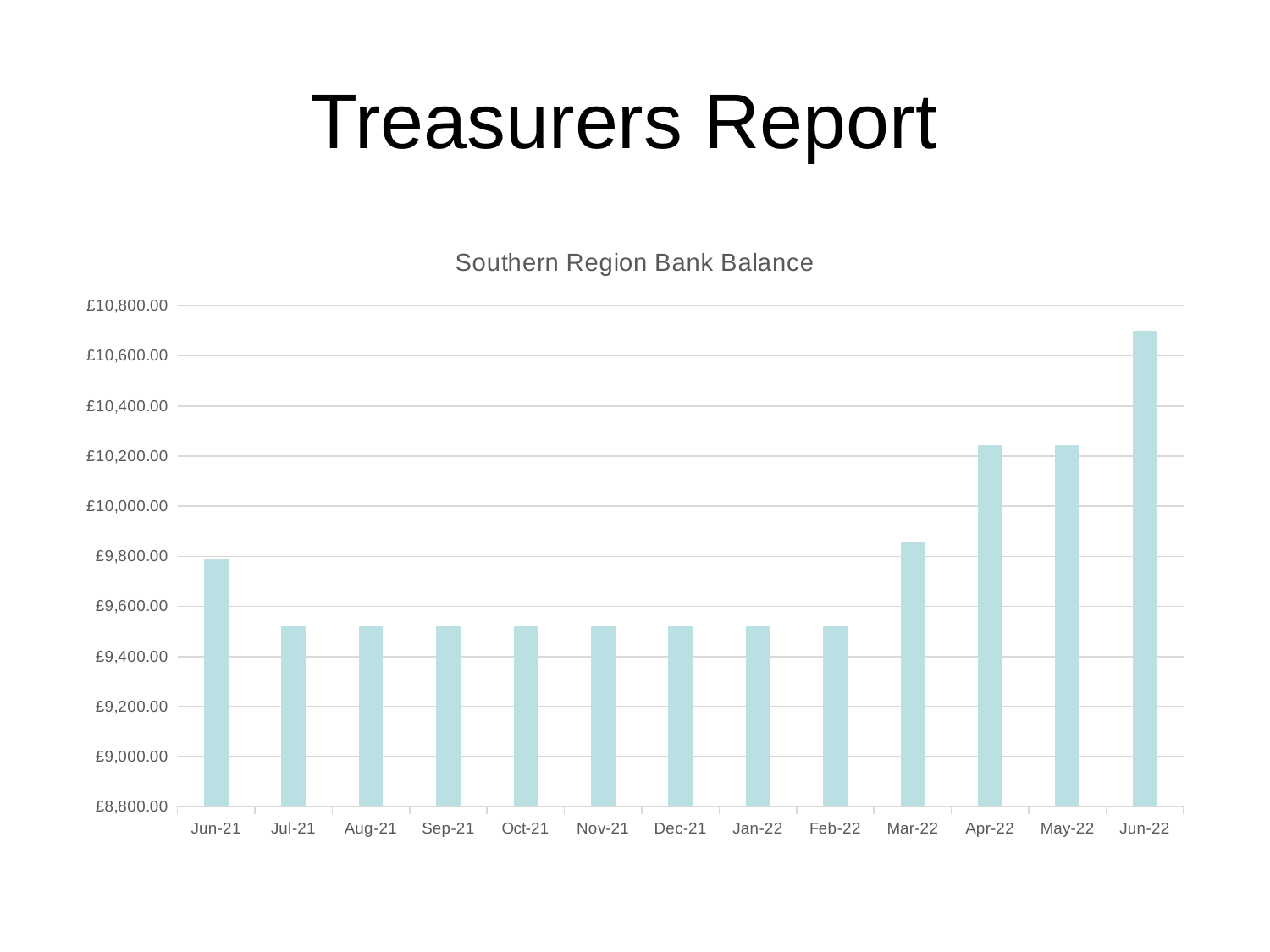
Which is larger, the value for Jun-21 or the value for Jul-21? Jun-21 What kind of chart is shown on the slide? bar chart Which is larger, the value for Jun-22 or the value for Mar-22? Jun-22 Is the value for Jun-22 greater or less than £10,600.00? greater Do the values rise or fall from Feb-22 to Jun-22? rise How many months are plotted on the x axis? 13 Which month has the highest bank balance? Jun-22 Is the value for Mar-22 greater or less than £10,000.00? less Is the value for Dec-21 greater or less than £9,600.00? less What is the title of the chart? Southern Region Bank Balance